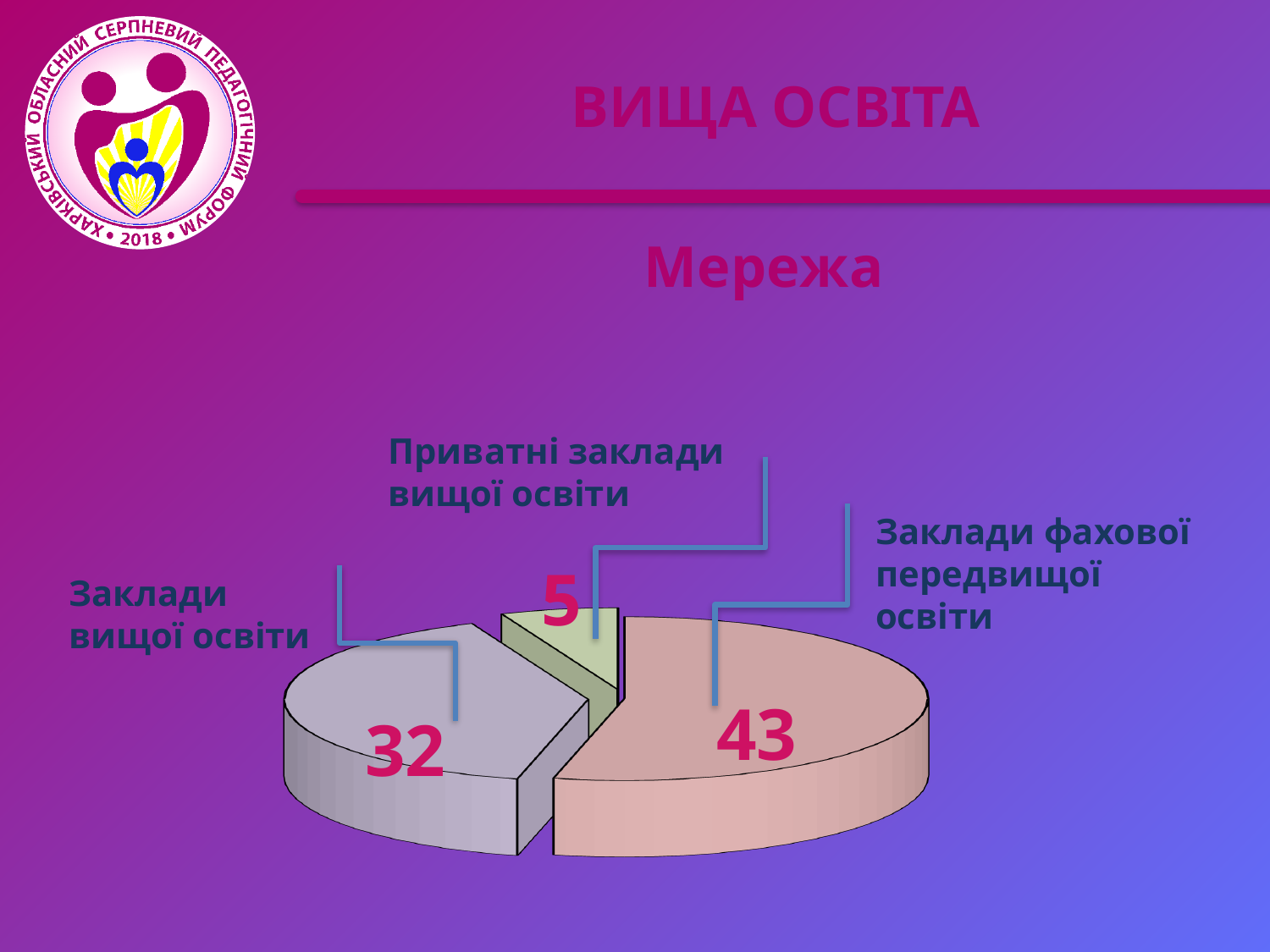
Which category has the largest slice of the pie? Заклади фахової передвищої освіти What kind of chart is shown on the slide? Pie chart What is the title of the chart? Мережа Which is larger: the value for Заклади вищої освіти or the value for Приватні заклади вищої освіти? Заклади вищої освіти Which category has the smallest slice of the pie? Приватні заклади вищої освіти How many slices does the pie chart have? 3 What share of the pie does Заклади вищої освіти represent? 40% What is the value for Заклади вищої освіти? 32 What is the difference between the values for Заклади вищої освіти and Приватні заклади вищої освіти? 27 What is the value for Приватні заклади вищої освіти? 5 What is the value for Заклади фахової передвищої освіти? 43 What is the difference between the values for Заклади фахової передвищої освіти and Заклади вищої освіти? 11